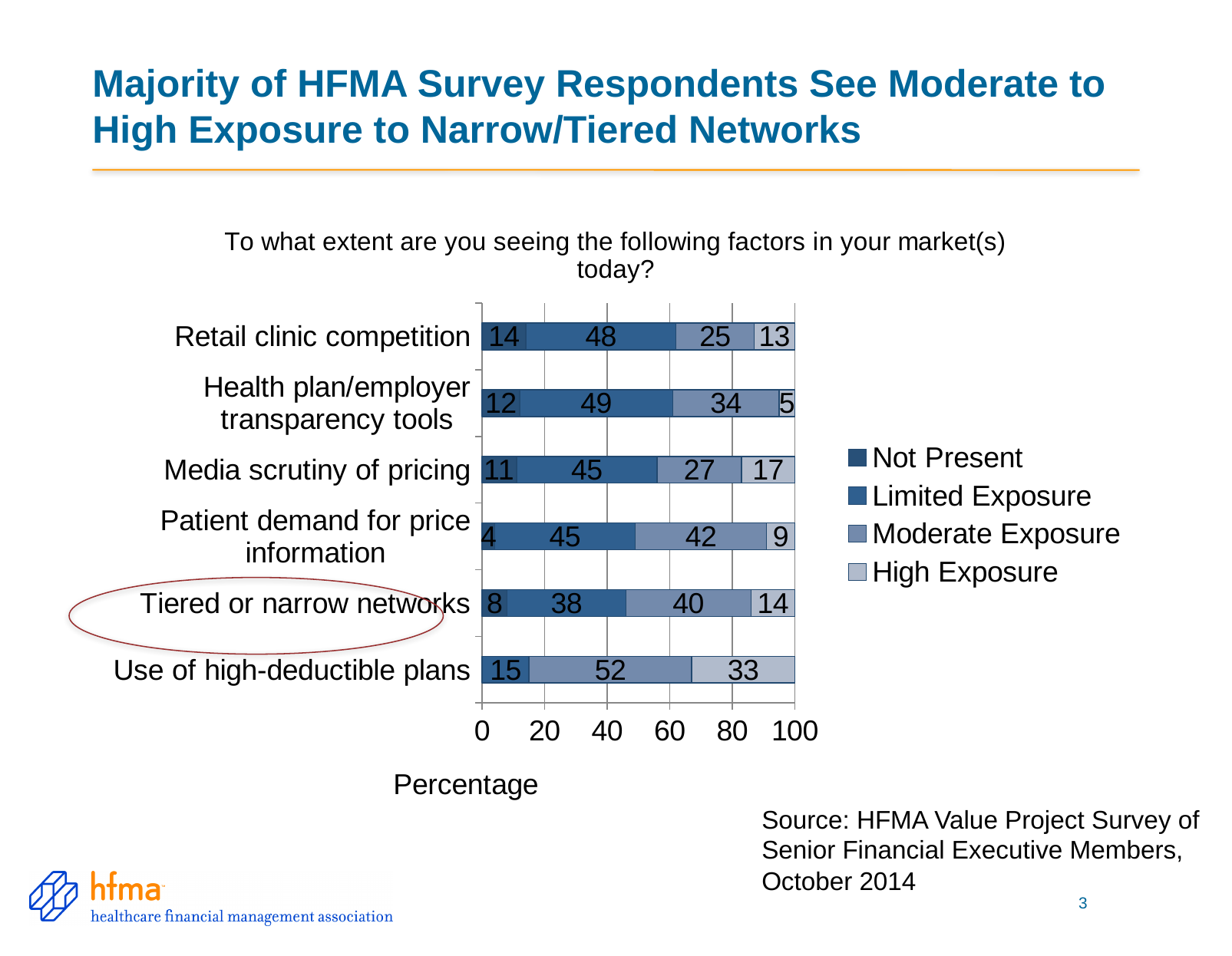
For Tiered or narrow networks, what is the difference between the Moderate Exposure and Limited Exposure values? 2 What is the Moderate Exposure value for Tiered or narrow networks? 40 Which category label on the chart is circled in red? Tiered or narrow networks Which factor has the highest High Exposure value? Use of high-deductible plans What is the High Exposure value for Media scrutiny of pricing? 17 How many factors (categories) are listed on the chart? 6 What is the Not Present value for Patient demand for price information? 4 Which has the larger Moderate Exposure value: Patient demand for price information or Tiered or narrow networks? Patient demand for price information Which factor has the lowest High Exposure value? Health plan/employer transparency tools What is the Limited Exposure value for Retail clinic competition? 48 How many series does the legend list? 4 What kind of chart is shown on the slide? Stacked bar chart